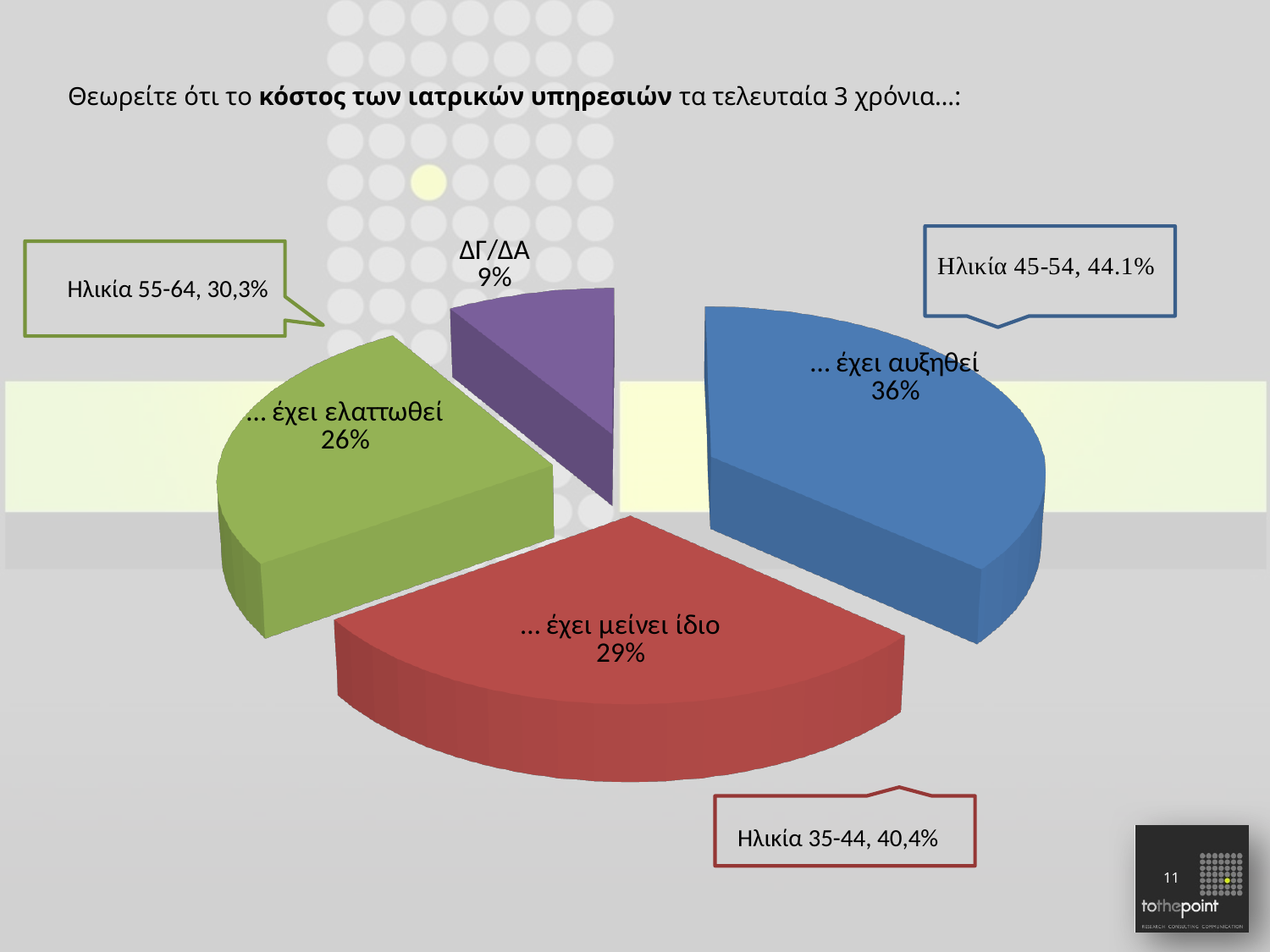
Which slice of the pie chart is the smallest? ΔΓ/ΔΑ What percentage is shown for the slice "... έχει αυξηθεί"? 36% What percentage is shown for the slice "ΔΓ/ΔΑ"? 9% How many slices does the pie chart have? 4 What percentage is shown for the slice "... έχει ελαττωθεί"? 26% What percentage is shown for the slice "... έχει μείνει ίδιο"? 29% What value does the callout for "Ηλικία 45-54" show? 44.1% What is the difference in percentage points between "... έχει αυξηθεί" and "... έχει ελαττωθεί"? 10 Which slice of the pie chart is the largest? ... έχει αυξηθεί Which is larger, the slice for "... έχει μείνει ίδιο" or the slice for "... έχει ελαττωθεί"? ... έχει μείνει ίδιο What kind of chart is shown on the slide? Pie chart What colour is the slice for "... έχει μείνει ίδιο"? Red